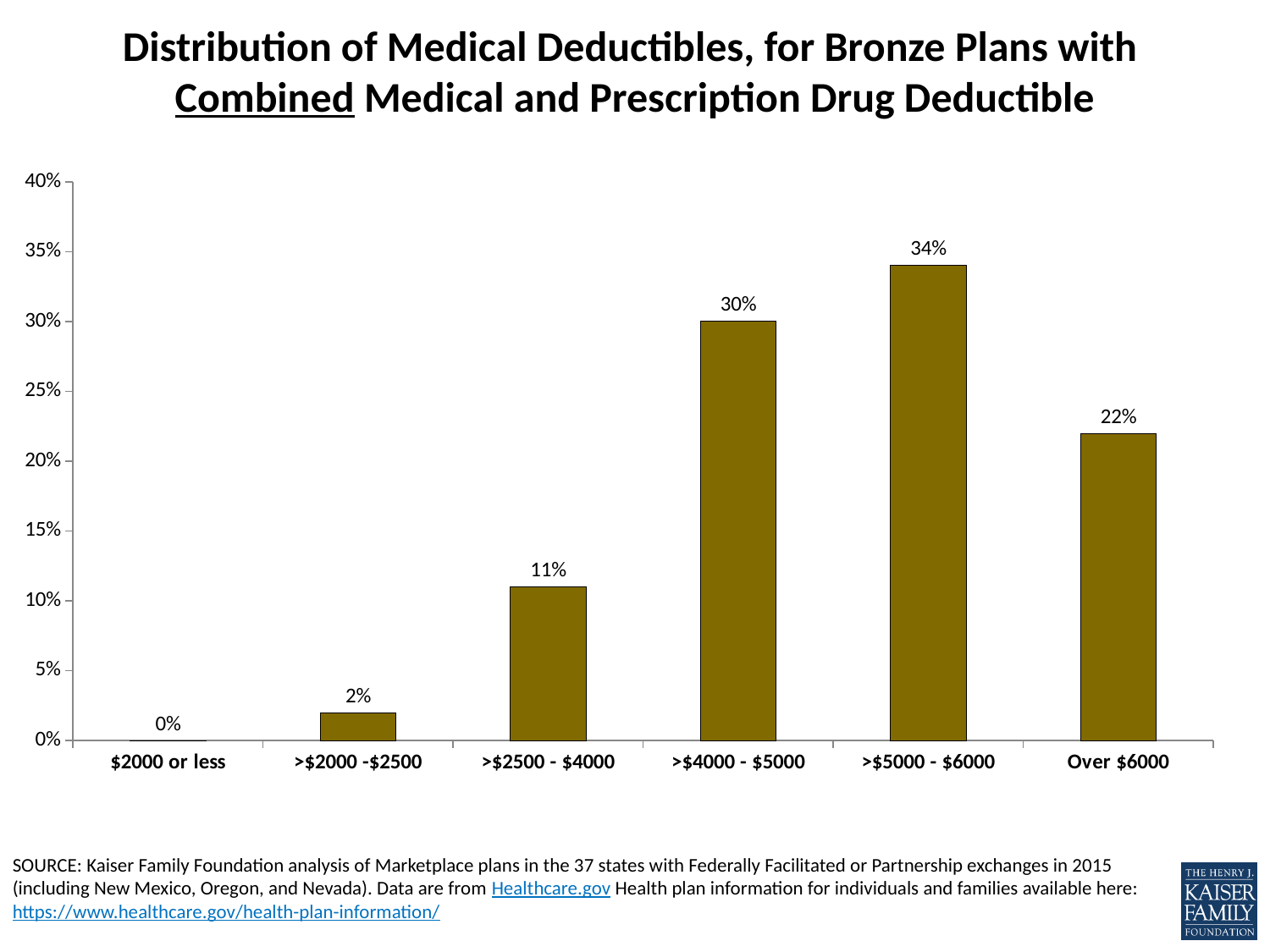
What is the value shown for the ">$2500 - $4000" category? 11% How many deductible categories are shown on the x axis? 6 What is the highest value shown on the vertical axis? 40% Which deductible category has the highest share of plans? >$5000 - $6000 What is the difference between the values for Over $6000 and >$2500 - $4000? 11% Which deductible category has the lowest share of plans? $2000 or less Which is larger, the value for >$4000 - $5000 or the value for Over $6000? >$4000 - $5000 What percentage of bronze plans with a combined deductible have a medical deductible of >$5000 - $6000? 34% Is the value for >$2000 -$2500 greater or less than 5%? less What is the value shown for the "Over $6000" category? 22% What is the difference between the values for >$5000 - $6000 and >$4000 - $5000? 4% What kind of chart is shown on the slide? Bar chart